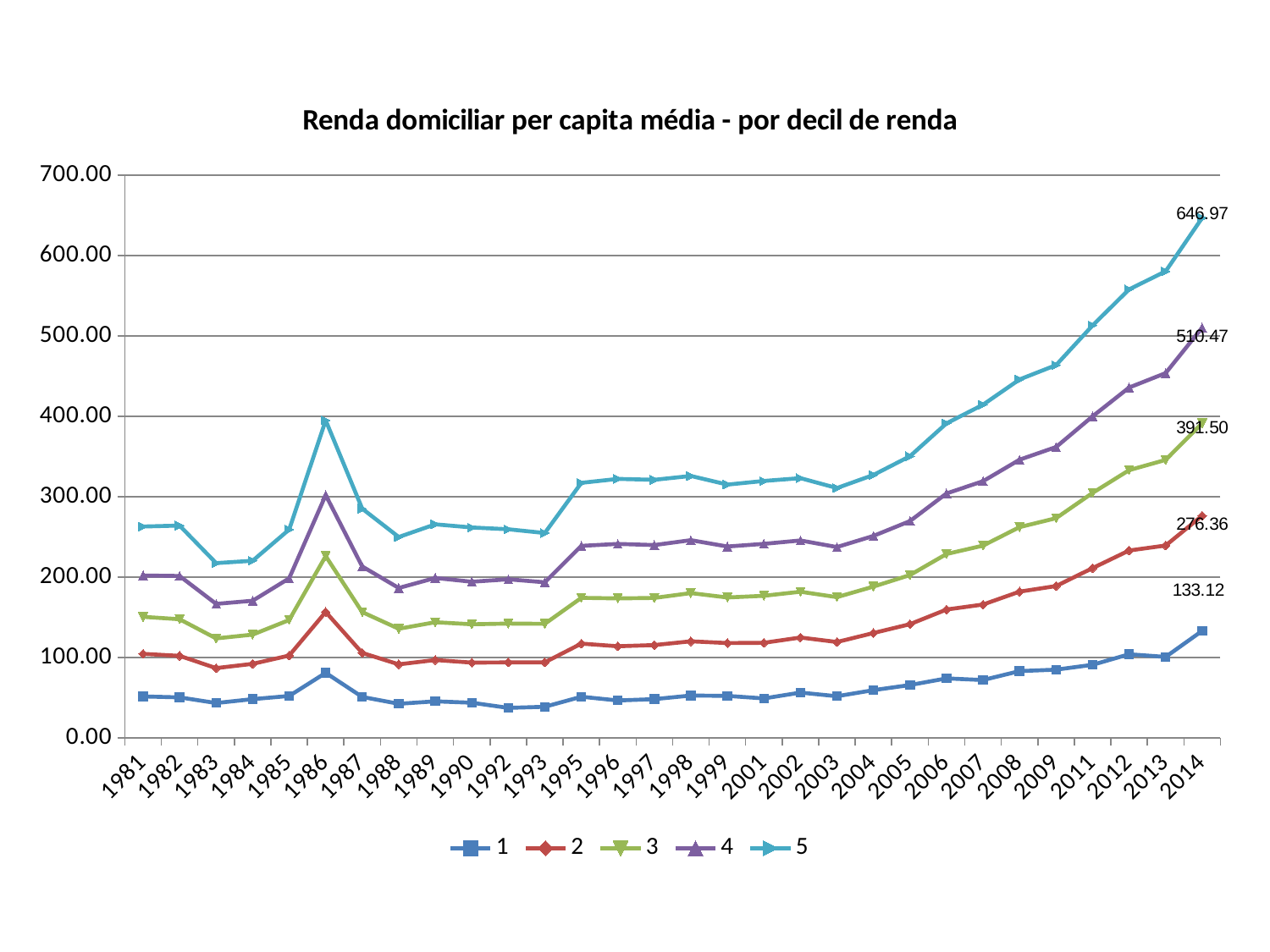
How many series does the legend list? 5 What is the value of series 3 in 2014? 391.50 What is the value of series 5 in 2014? 646.97 What is the difference between series 5 and series 4 in 2014? 136.50 Which series has the highest value in 2014? 5 How many years are shown on the x axis? 30 What is the difference between series 2 and series 1 in 2014? 143.24 What is the title of the chart? Renda domiciliar per capita média - por decil de renda What is the value of series 1 in 2014? 133.12 What kind of chart is shown on the slide? line chart What is the value of series 4 in 2014? 510.47 Is the value for series 5 in 1986 greater or less than 300? greater